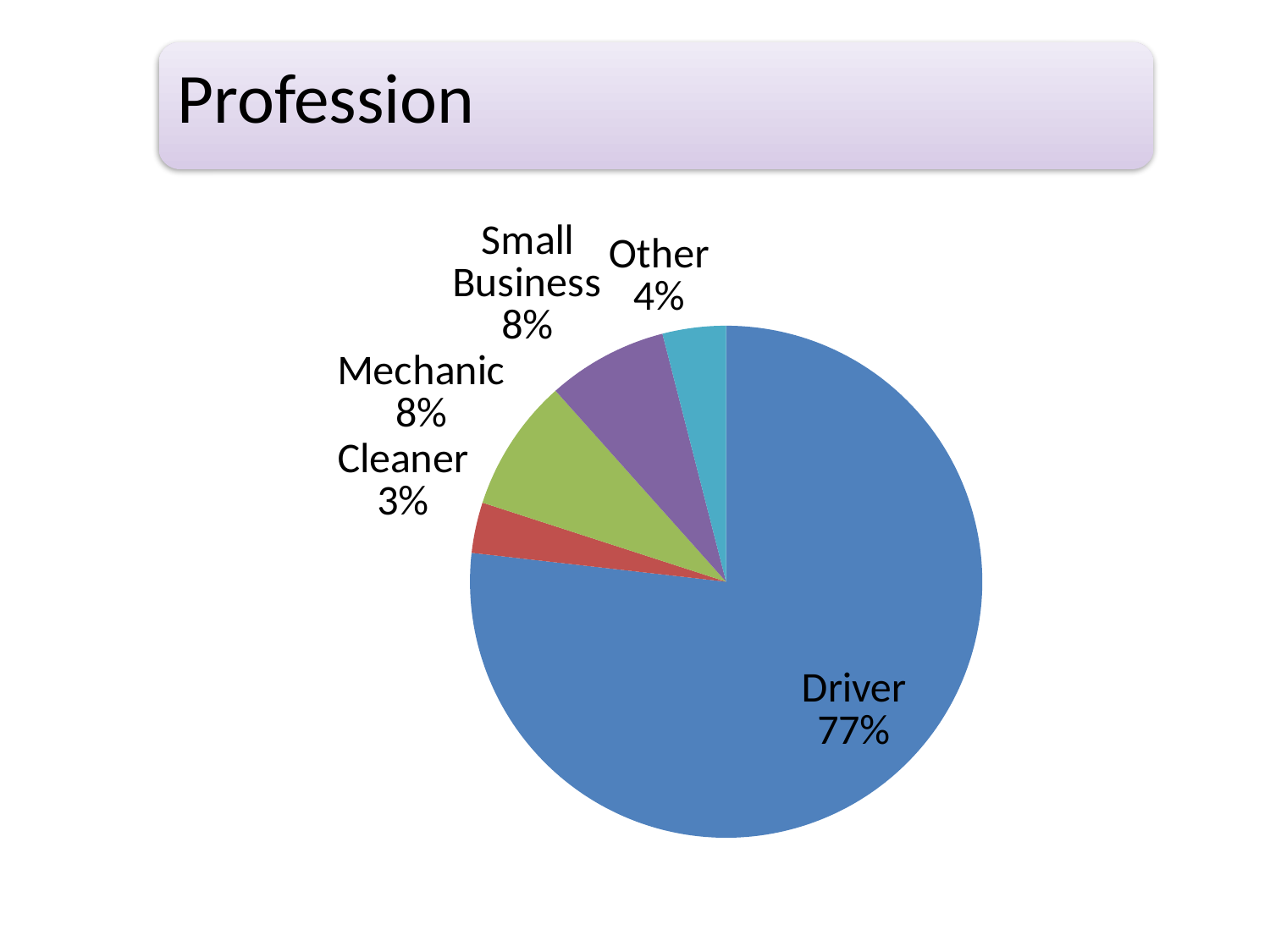
Which category has the smallest slice of the pie? Cleaner What is the value for Cleaner? 3% What is the title of the slide containing the pie chart? Profession What share of the pie does Driver account for? 77% Which is larger, the share for Other or the share for Cleaner? Other What is the value for Mechanic? 8% What kind of chart is shown on the slide? pie chart What is the value for Other? 4% What is the difference between the Driver share and the Small Business share? 69% Which category has the largest slice of the pie? Driver What colour is the Driver slice? blue How many categories are shown in the pie chart? 5